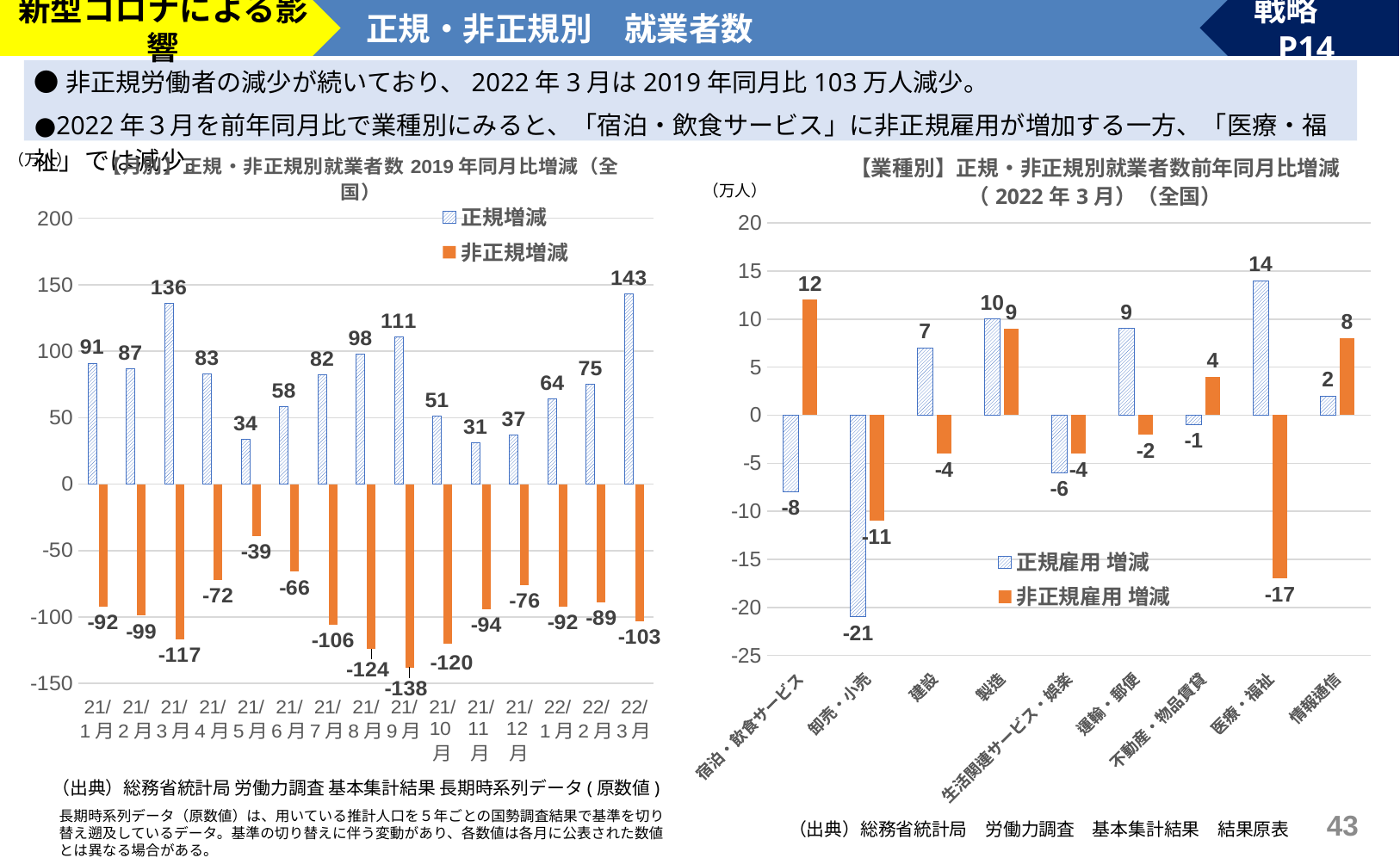
In the left chart (【月別】正規・非正規別就業者数 2019年同月比増減), which month has the highest 正規増減 value? 22/3月 In the right chart (【業種別】正規・非正規別就業者数前年同月比増減), which industry has the lowest 正規雇用 増減 value? 卸売・小売 What kind of chart is the right chart (【業種別】正規・非正規別就業者数前年同月比増減)? bar chart In the left chart (【月別】正規・非正規別就業者数 2019年同月比増減), how many months are shown on the x axis? 15 In the right chart (【業種別】正規・非正規別就業者数前年同月比増減), what is the 非正規雇用 増減 value for 医療・福祉? -17 In the right chart (【業種別】正規・非正規別就業者数前年同月比増減), which is larger, the 非正規雇用 増減 value for 宿泊・飲食サービス or for 情報通信? 宿泊・飲食サービス In the left chart (【月別】正規・非正規別就業者数 2019年同月比増減), what is the difference between the 正規増減 values for 21/3月 and 21/5月? 102 In the left chart (【月別】正規・非正規別就業者数 2019年同月比増減), which month has the lowest 正規増減 value? 21/11月 In the left chart (【月別】正規・非正規別就業者数 2019年同月比増減), how many series does the legend list? 2 In the left chart (【月別】正規・非正規別就業者数 2019年同月比増減), what is the 非正規増減 value for 21/9月? -138 In the left chart (【月別】正規・非正規別就業者数 2019年同月比増減), what is the 正規増減 value for 22/3月? 143 In the right chart (【業種別】正規・非正規別就業者数前年同月比増減), how many industries are shown on the x axis? 9